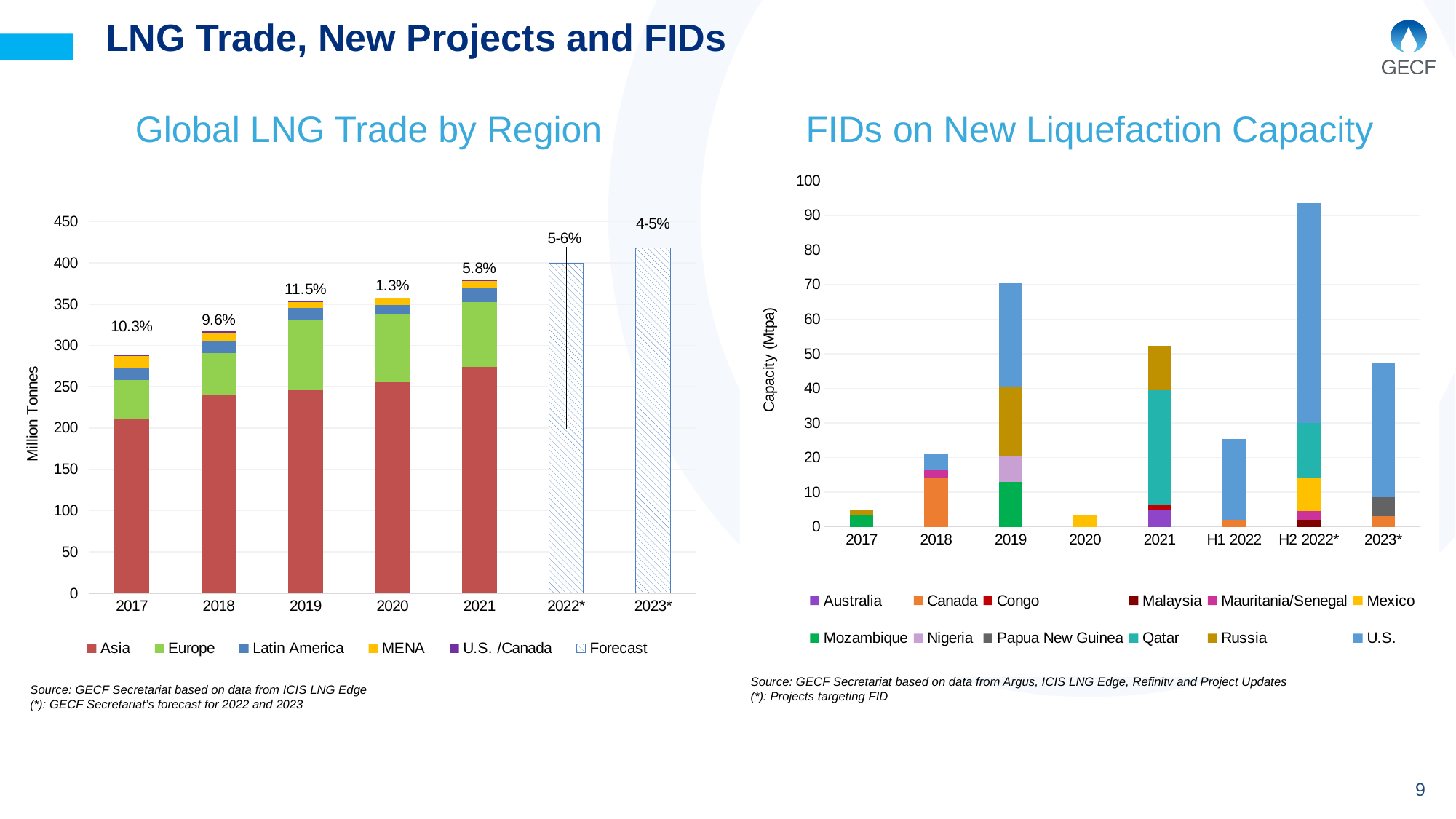
In the FIDs on New Liquefaction Capacity chart, which has the larger total: 2021 or H1 2022? 2021 In the Global LNG Trade by Region chart, which year has the lowest growth rate label? 2020 In the FIDs on New Liquefaction Capacity chart, which period has the highest total capacity? H2 2022* In the Global LNG Trade by Region chart, is the total for 2021 greater or less than 350? greater How many series does the legend of the FIDs on New Liquefaction Capacity chart list? 12 In the Global LNG Trade by Region chart, what growth rate label is shown above the 2017 bar? 10.3% How many categories are shown on the x axis of the FIDs on New Liquefaction Capacity chart? 8 What kind of chart is the Global LNG Trade by Region chart? Stacked bar chart How many entries does the legend of the Global LNG Trade by Region chart list? 6 In the Global LNG Trade by Region chart, what growth rate label is shown above the 2019 bar? 11.5% In the FIDs on New Liquefaction Capacity chart, is the total for 2019 greater or less than 60? greater In the Global LNG Trade by Region chart, what label is shown above the 2023* forecast bar? 4-5%